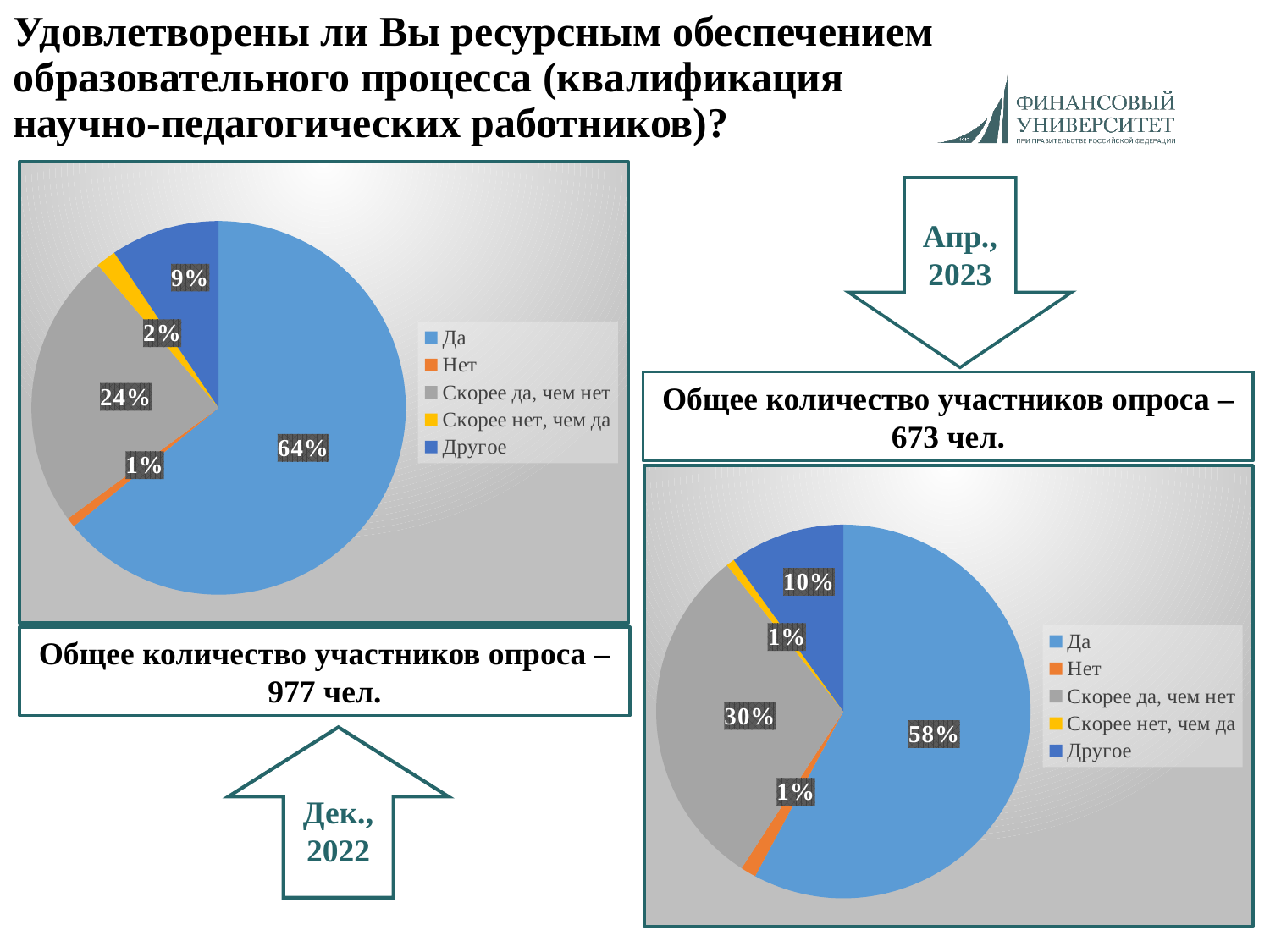
In the right pie chart (Апр., 2023), what share of respondents answered "Скорее да, чем нет"? 30% What type of chart is used on the left side of the slide (Дек., 2022)? Pie chart How many answer categories does the legend of the right pie chart (Апр., 2023) list? 5 In the left pie chart (Дек., 2022), what is the difference between the shares for "Да" and "Скорее да, чем нет"? 40% In the left pie chart (Дек., 2022), what share of respondents answered "Да"? 64% In the right pie chart (Апр., 2023), what colour represents "Скорее нет, чем да"? Yellow In the left pie chart (Дек., 2022), what share is labelled for "Другое"? 9% Which chart shows a larger share for "Да": the left (Дек., 2022) or the right (Апр., 2023)? Left (Дек., 2022) In the left pie chart (Дек., 2022), which answer has the smallest share? Нет In the right pie chart (Апр., 2023), what share is labelled for "Другое"? 10% In the right pie chart (Апр., 2023), which answer has the largest share? Да In the left pie chart (Дек., 2022), which answer has the largest share? Да